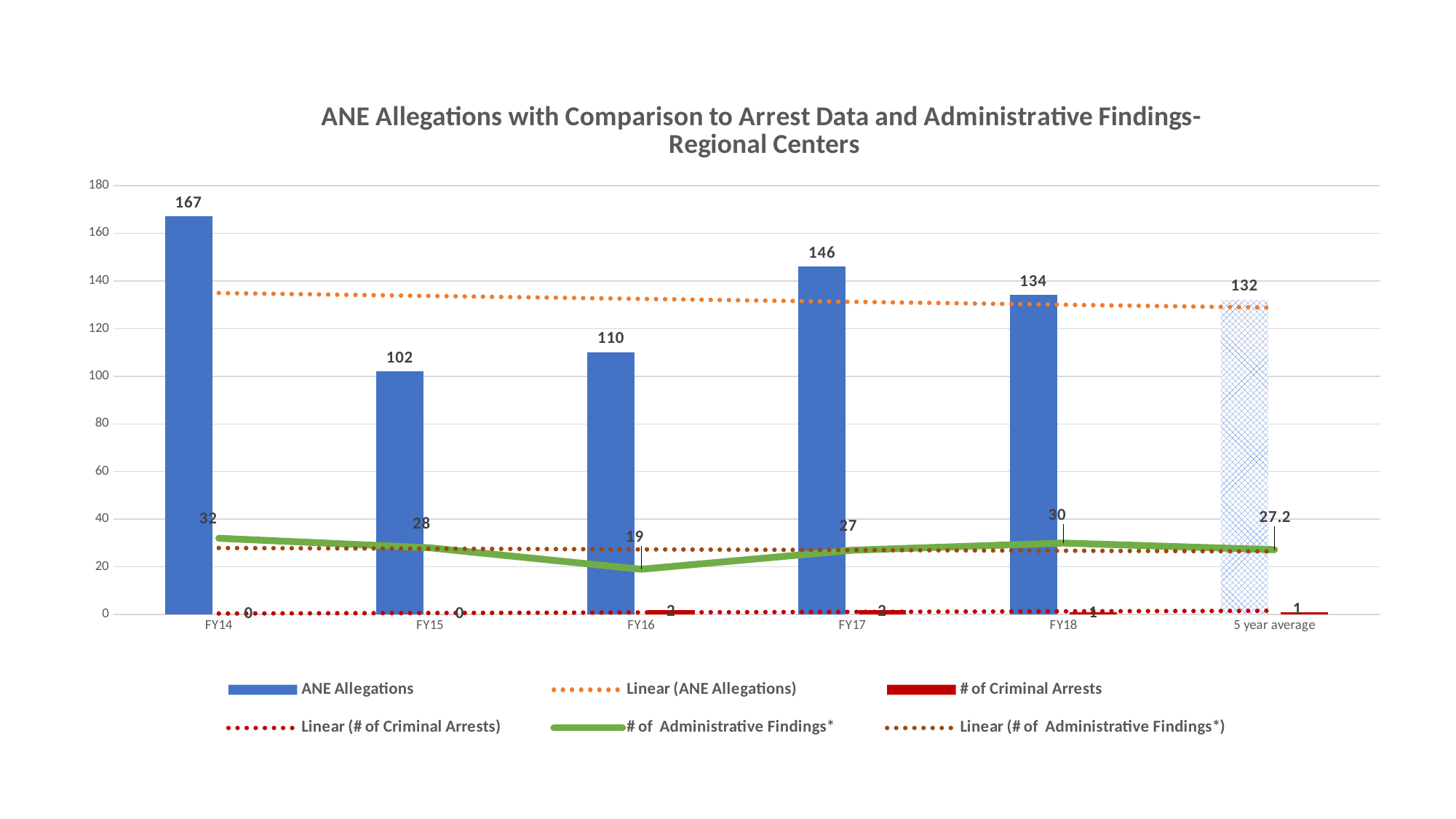
Which fiscal year has the highest number of ANE Allegations? FY14 What is the 5 year average value for # of Administrative Findings? 27.2 What is the ANE Allegations value for the 5 year average? 132 How many series does the legend list? 6 What is the number of Administrative Findings for FY16? 19 How many categories are shown on the x axis? 6 How many Criminal Arrests are shown for FY14? 0 Which year had more ANE Allegations, FY17 or FY18? FY17 Which fiscal year has the lowest number of Administrative Findings? FY16 What is the difference in ANE Allegations between FY14 and FY15? 65 What is the value of ANE Allegations for FY14? 167 Which fiscal year has the lowest number of ANE Allegations? FY15